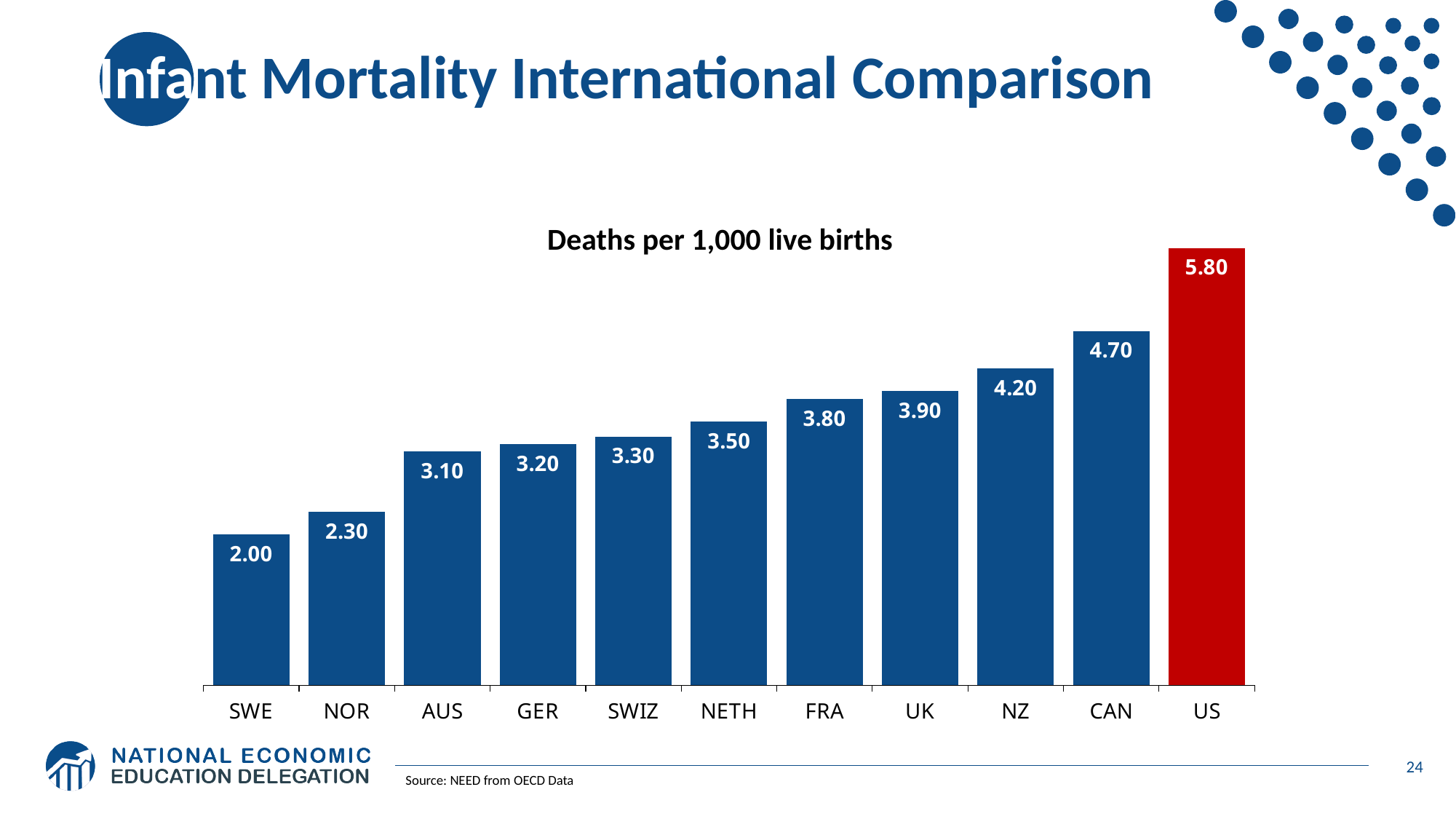
Which is larger, the value for FRA or the value for GER? FRA Which country has the highest value? US Do the values rise or fall from left to right across the chart? Rise What is the value for NETH? 3.50 Which country has the lowest value? SWE What is the difference between the values for the US and CAN? 1.10 What is the value for the US? 5.80 What is the value for SWE? 2.00 What is the title of the chart? Deaths per 1,000 live births How many countries are shown on the chart? 11 What is the difference between the values for AUS and NOR? 0.80 What kind of chart is shown on the slide? Bar chart